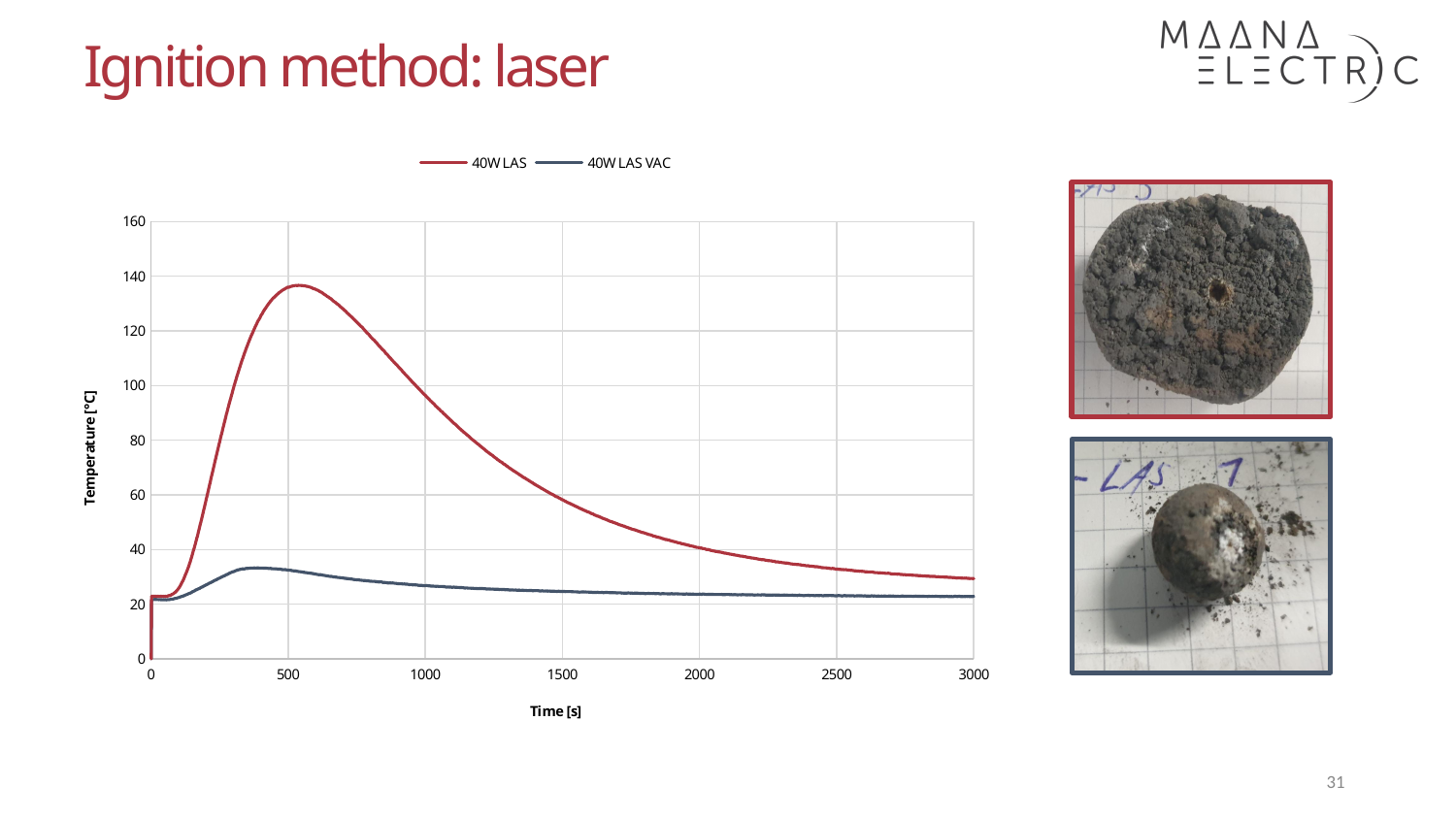
Is the temperature of the 40W LAS series at 3000 s greater or less than 40? less What are the two series named in the chart legend? 40W LAS and 40W LAS VAC Is the peak temperature of the 40W LAS VAC series greater or less than 40? less Is the temperature of the 40W LAS VAC series at 2000 s greater or less than 40? less What is the label of the y axis of the chart? Temperature [°C] Which series reaches the higher peak temperature, 40W LAS or 40W LAS VAC? 40W LAS What kind of chart is shown on the slide? line chart Does the temperature of the 40W LAS series rise or fall between 1000 s and 3000 s? fall Does the temperature of the 40W LAS series rise or fall between 0 s and 500 s? rise How many series does the chart legend list? 2